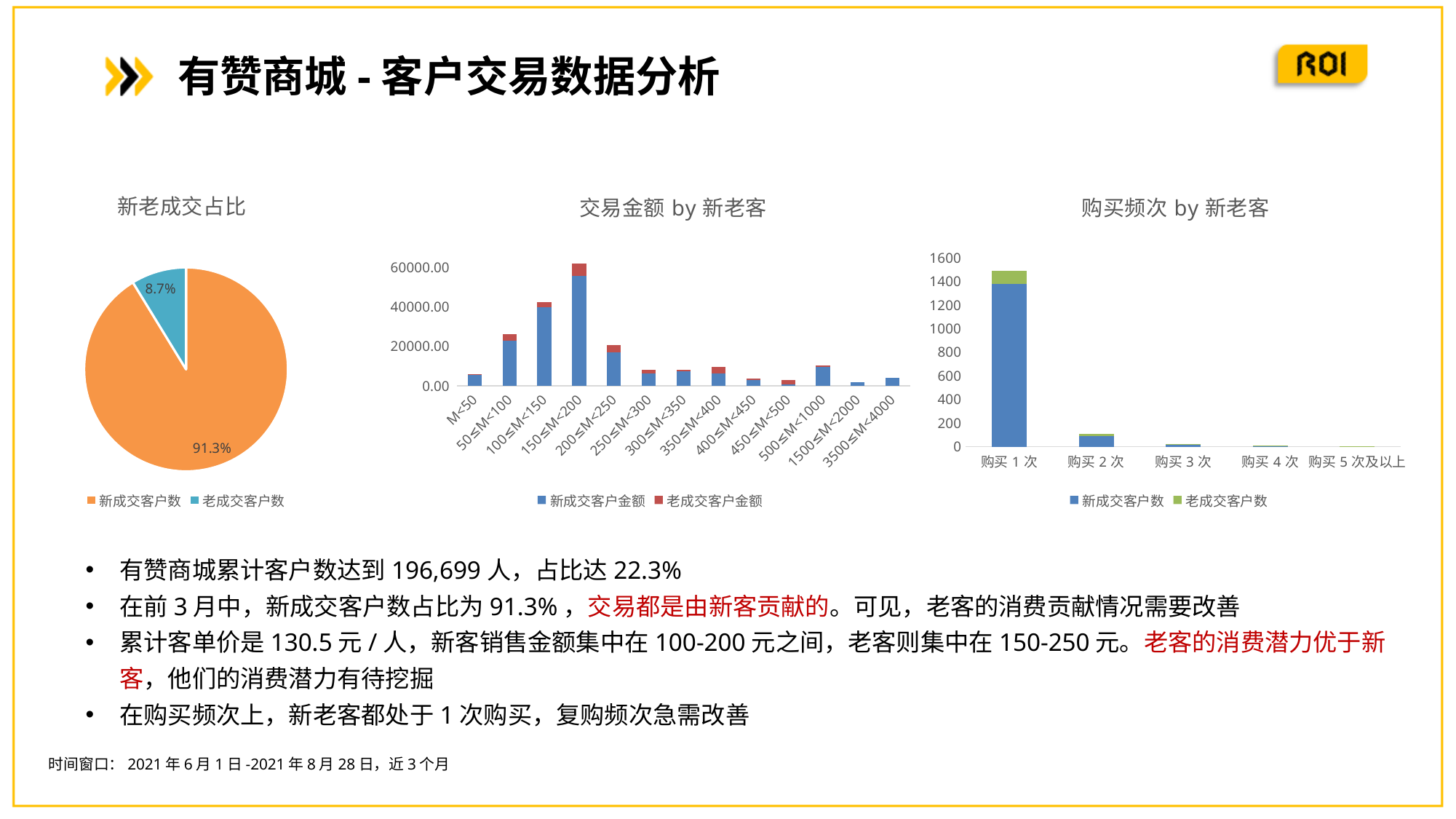
In the 交易金额 by 新老客 chart, is the total bar for 50≤M<100 greater or less than 40000.00? less In the 新老成交占比 pie chart, what share is labelled for 老成交客户数? 8.7% What kind of chart is the 购买频次 by 新老客 chart? bar chart In the 交易金额 by 新老客 chart, which amount range has the highest total bar? 150≤M<200 What kind of chart is the 新老成交占比 chart? pie chart In the 新老成交占比 chart, which slice is larger, 新成交客户数 or 老成交客户数? 新成交客户数 How many series does the legend of the 交易金额 by 新老客 chart list? 2 In the 新老成交占比 pie chart, what share is labelled for 新成交客户数? 91.3% In the 交易金额 by 新老客 chart, is the 新成交客户金额 value for 150≤M<200 greater or less than 40000.00? greater How many amount ranges are shown on the x axis of the 交易金额 by 新老客 chart? 13 In the 购买频次 by 新老客 chart, is the 新成交客户数 value for 购买 1 次 greater or less than 1200? greater In the 购买频次 by 新老客 chart, which purchase-frequency category has the highest bar? 购买 1 次